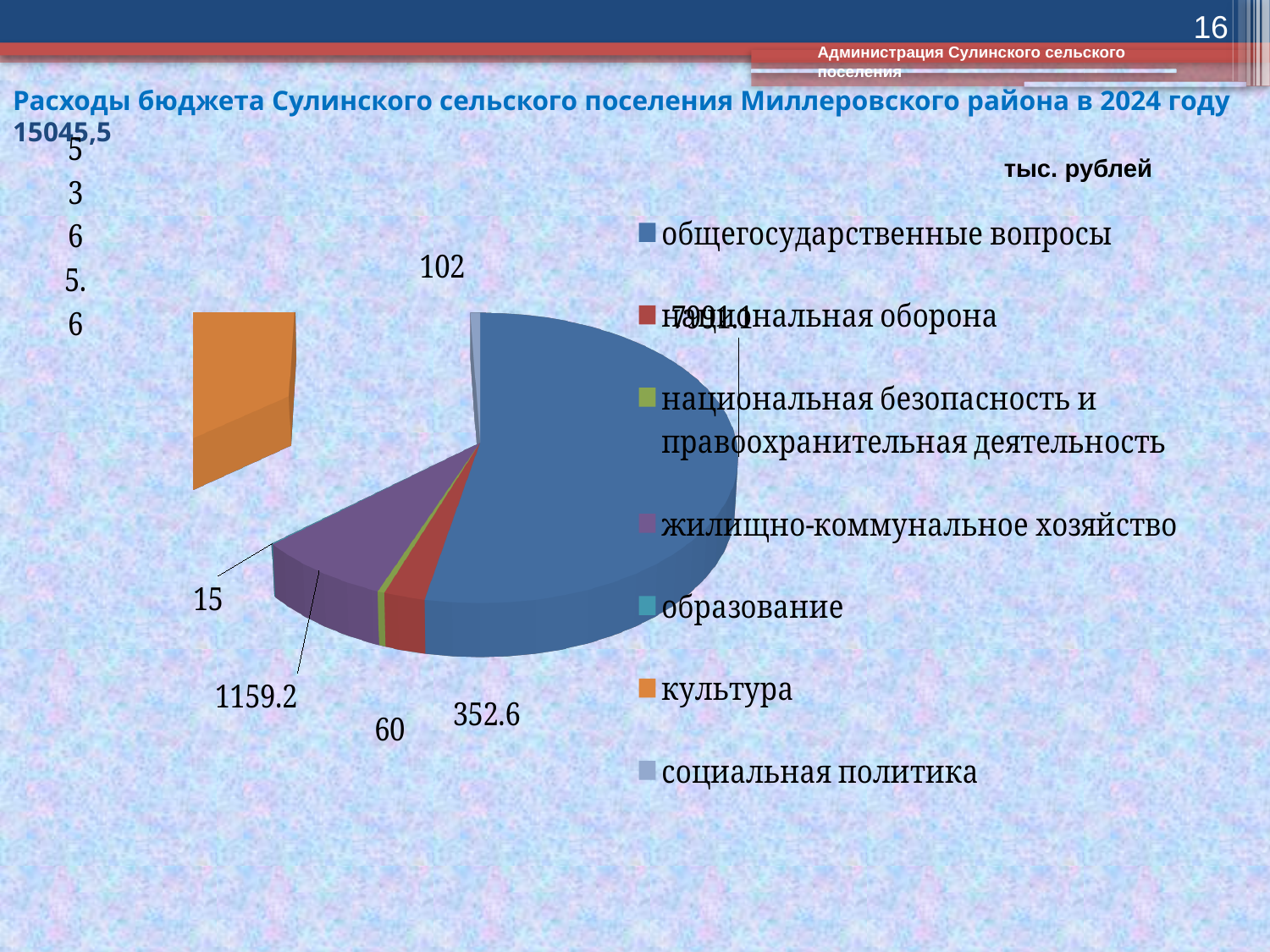
How many categories does the legend of the pie chart list? 7 What is the value shown for культура? 5365.6 What is the difference between the values for жилищно-коммунальное хозяйство and национальная оборона? 806.6 What kind of chart is shown on the slide? pie chart Which category has the largest slice of the pie chart? общегосударственные вопросы Which category has the smallest slice of the pie chart? образование Which is larger, the value for культура or the value for жилищно-коммунальное хозяйство? культура In what units are the values of the chart given, according to the label on the slide? тыс. рублей What is the value shown for национальная безопасность и правоохранительная деятельность? 60 What is the value shown for социальная политика? 102 What is the value shown for жилищно-коммунальное хозяйство? 1159.2 What is the value shown for национальная оборона? 352.6